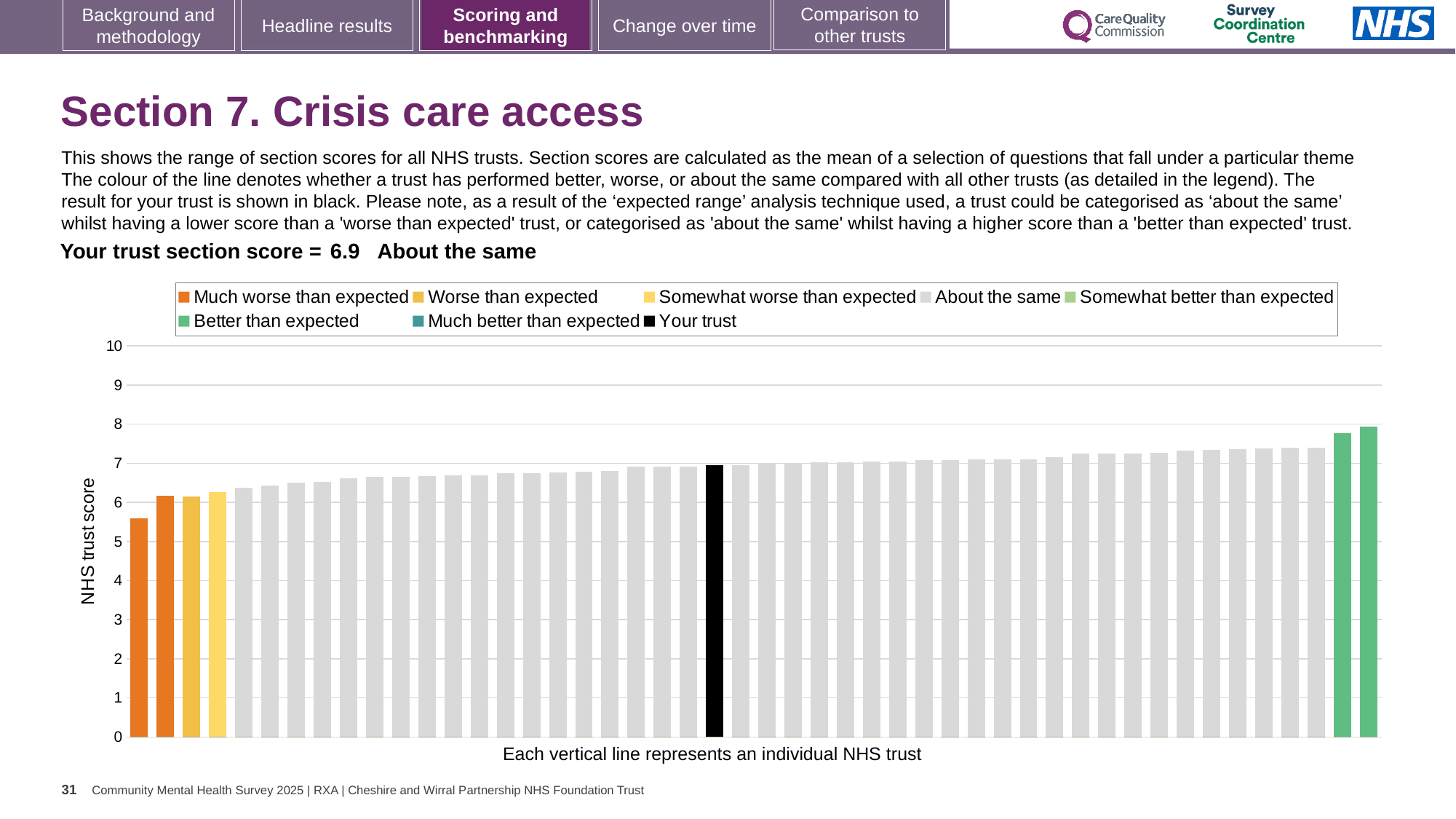
What colour is the bar representing your trust? black How many bars are coloured green (Better than expected)? 2 Do the bar values rise or fall moving from left to right along the x axis? rise Is the value for your trust (the black bar) greater or less than 5? greater How many entries does the chart legend list? 8 What type of chart is shown on the slide? bar chart Which is larger: the value of the rightmost bar or the value of the black bar? the rightmost bar What is the label on the y axis of the chart? NHS trust score How many bars are coloured orange (Much worse than expected)? 2 Is the value of the highest bar (rightmost) greater or less than 7? greater What is the section score for your trust shown on the slide? 6.9 Is the value of the lowest bar (leftmost) greater or less than 6? less